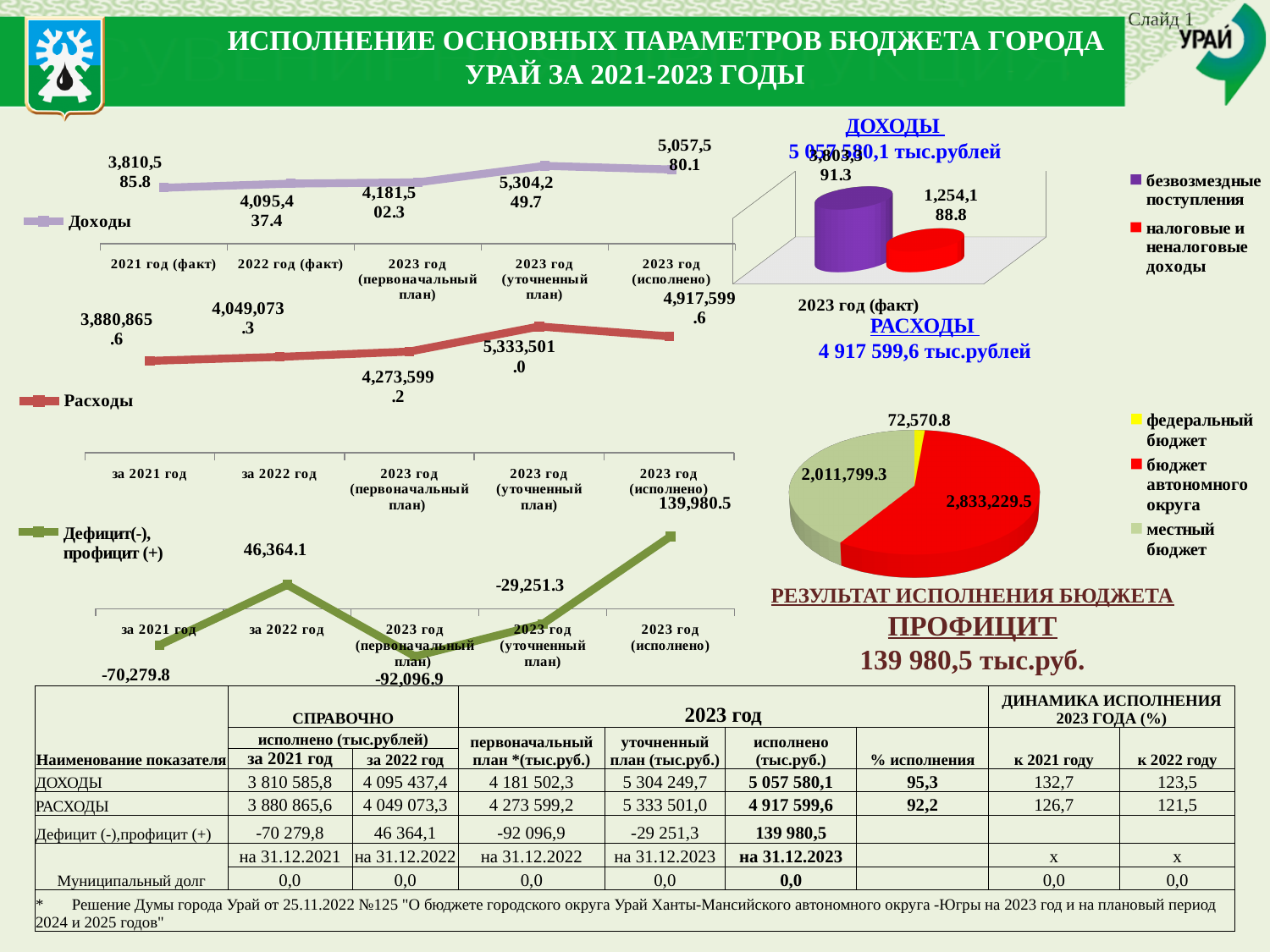
In the РАСХОДЫ pie chart, which category has the largest slice? бюджет автономного округа In the РАСХОДЫ pie chart, which category has the smallest slice? федеральный бюджет In the РАСХОДЫ pie chart, what is the difference between the бюджет автономного округа slice and the местный бюджет slice? 821,430.2 In the Дефицит(-), профицит (+) line chart, what is the value for 2023 год (исполнено)? 139,980.5 In the РАСХОДЫ pie chart, what is the value for местный бюджет? 2,011,799.3 What kind of chart is the ДОХОДЫ chart on the right of the slide? bar chart In the ДОХОДЫ bar chart, which is larger: безвозмездные поступления or налоговые и неналоговые доходы? безвозмездные поступления How many entries does the legend of the РАСХОДЫ pie chart list? 3 In the Дефицит(-), профицит (+) line chart, which category has the lowest value? 2023 год (первоначальный план) What kind of chart is the РАСХОДЫ chart on the right of the slide? pie chart In the РАСХОДЫ pie chart, what is the value for федеральный бюджет? 72,570.8 In the Дефицит(-), профицит (+) line chart, what is the value for за 2022 год? 46,364.1